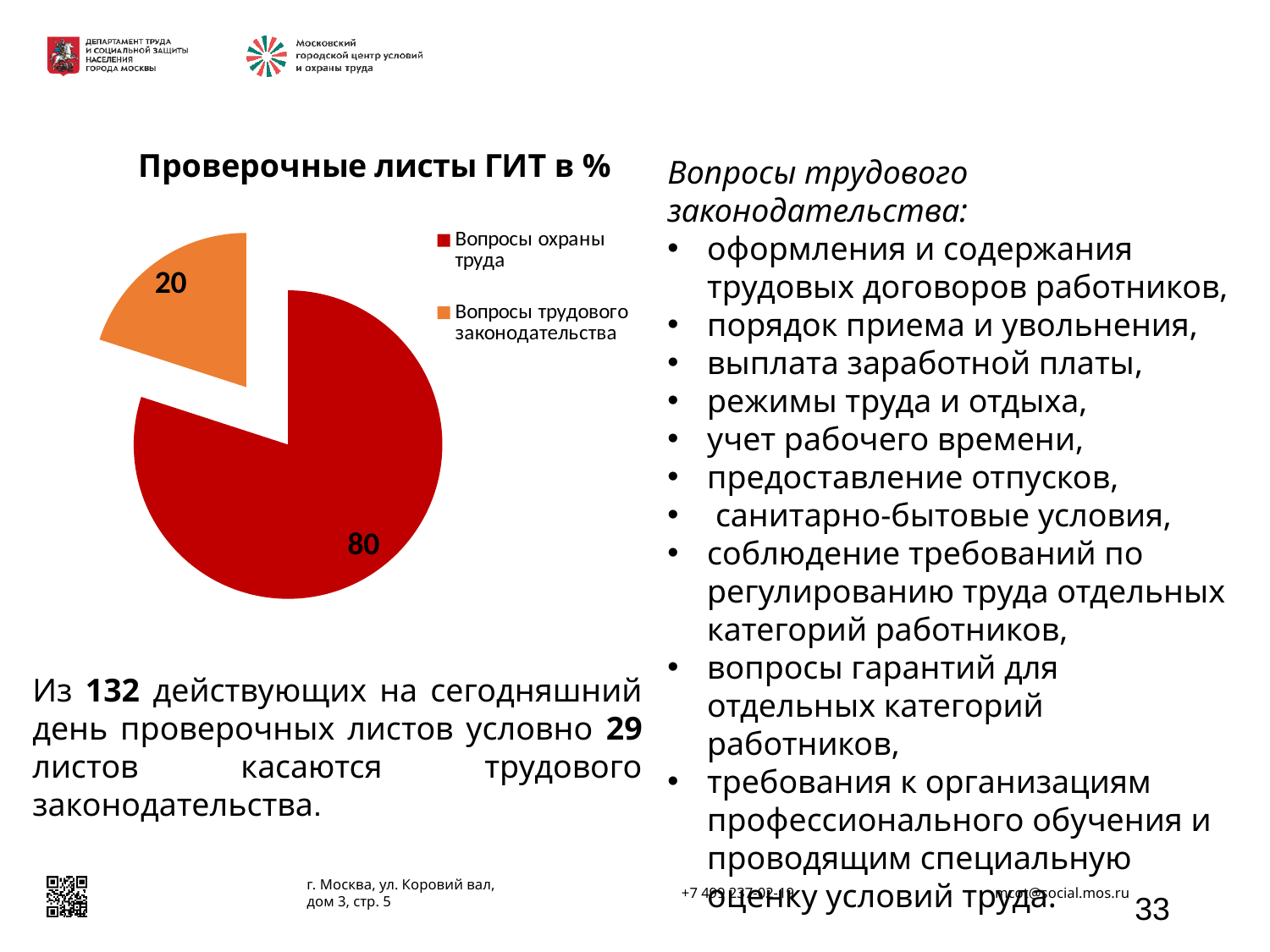
What type of chart is shown on the slide? pie chart Which is larger: the value for "Вопросы охраны труда" or for "Вопросы трудового законодательства"? Вопросы охраны труда What colour is the slice for "Вопросы трудового законодательства"? orange How many entries does the legend list? 2 Which category has the largest slice of the pie? Вопросы охраны труда What is the title of the chart? Проверочные листы ГИТ в % What is the difference between the values for "Вопросы охраны труда" and "Вопросы трудового законодательства"? 60 What is the value shown for "Вопросы охраны труда"? 80 What share of the pie does "Вопросы трудового законодательства" represent? 20% Which category has the smallest slice of the pie? Вопросы трудового законодательства How many slices does the pie chart have? 2 What is the value shown for "Вопросы трудового законодательства"? 20